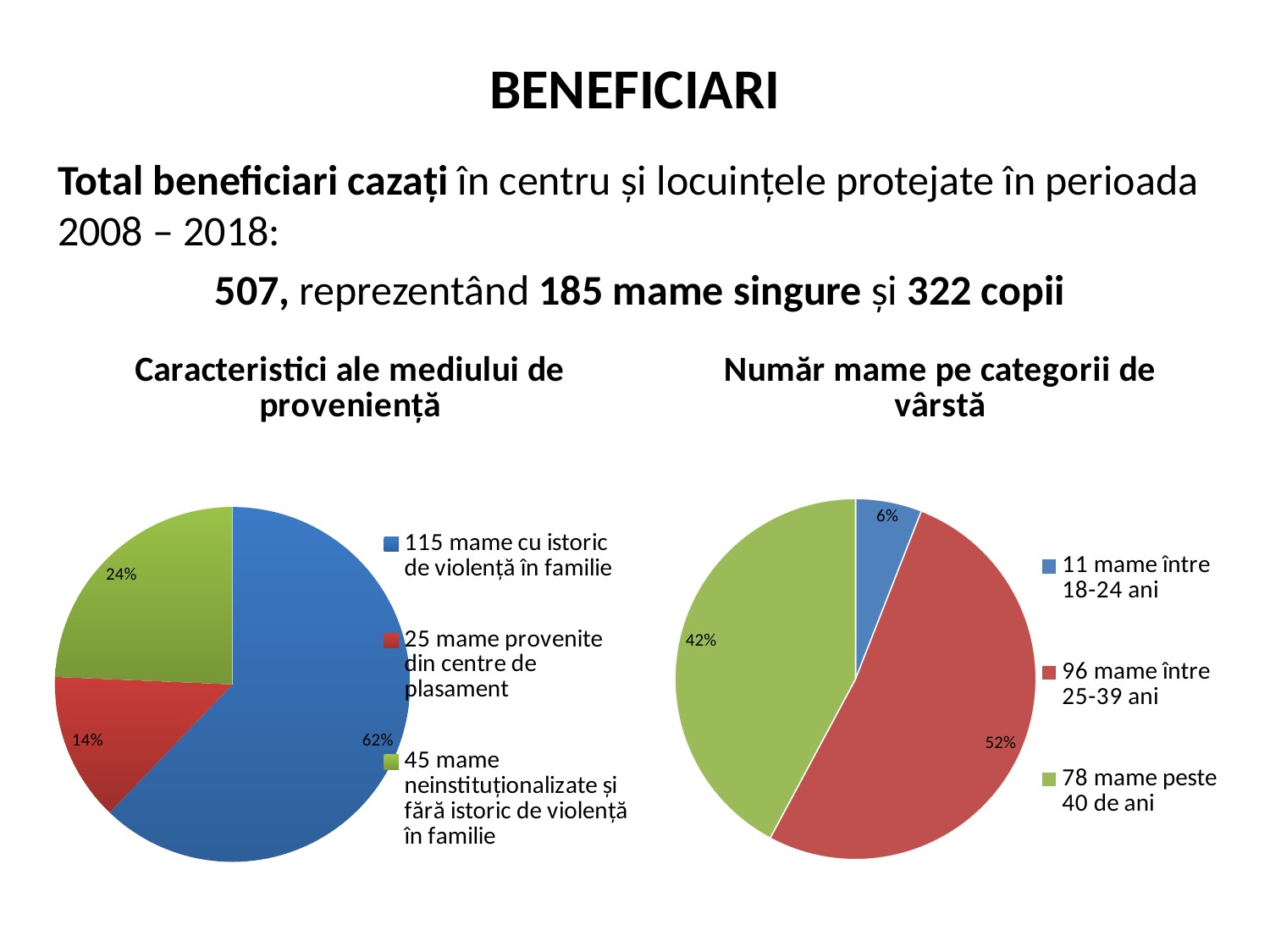
In the chart titled 'Număr mame pe categorii de vârstă', which age category has the largest share? 96 mame între 25-39 ani In the chart titled 'Caracteristici ale mediului de proveniență', what percentage is shown for the slice '115 mame cu istoric de violență în familie'? 62% In the chart titled 'Număr mame pe categorii de vârstă', what percentage is shown for '11 mame între 18-24 ani'? 6% In the chart titled 'Caracteristici ale mediului de proveniență', what is the difference in percentage points between the 62% slice and the 24% slice? 38 In the chart titled 'Număr mame pe categorii de vârstă', what percentage is shown for '96 mame între 25-39 ani'? 52% In the chart titled 'Caracteristici ale mediului de proveniență', what percentage is shown for the slice '45 mame neinstituționalizate și fără istoric de violență în familie'? 24% How many slices does the chart titled 'Număr mame pe categorii de vârstă' have? 3 What type of chart is the chart titled 'Caracteristici ale mediului de proveniență'? Pie chart In the chart titled 'Caracteristici ale mediului de proveniență', which category has the largest slice? 115 mame cu istoric de violență în familie In the chart titled 'Număr mame pe categorii de vârstă', what percentage is shown for '78 mame peste 40 de ani'? 42% In the chart titled 'Caracteristici ale mediului de proveniență', which category has the smallest slice? 25 mame provenite din centre de plasament In the chart titled 'Caracteristici ale mediului de proveniență', what percentage is shown for the slice '25 mame provenite din centre de plasament'? 14%